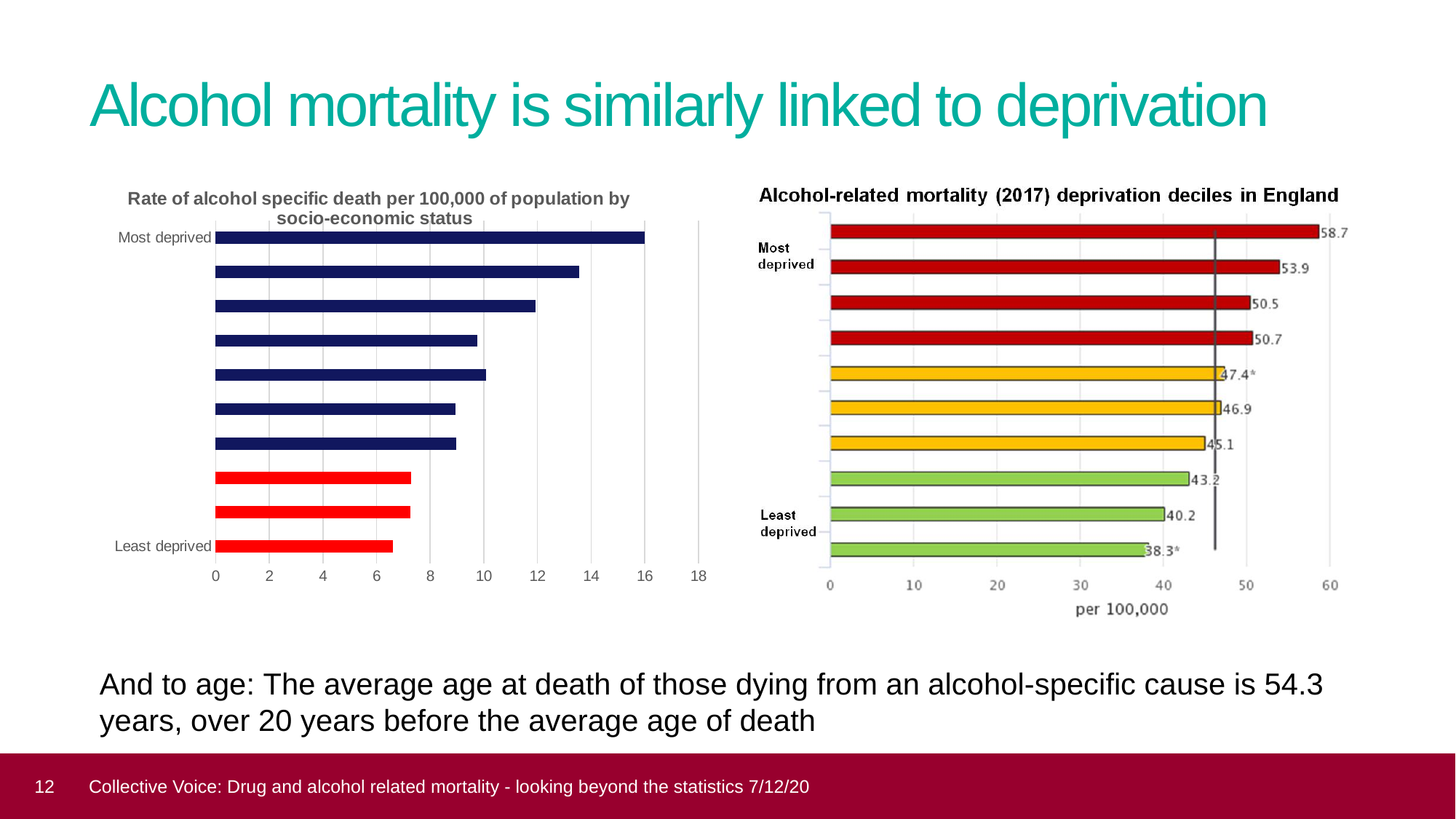
On the left chart (Rate of alcohol specific death per 100,000 of population by socio-economic status), is the value for Least deprived greater or less than 8? less On the left chart (Rate of alcohol specific death per 100,000 of population by socio-economic status), how many bars are plotted? 10 What kind of chart is the left chart (Rate of alcohol specific death per 100,000 of population by socio-economic status)? bar chart On the right chart (Alcohol-related mortality (2017) deprivation deciles in England), what is the lowest value shown? 38.3* On the left chart (Rate of alcohol specific death per 100,000 of population by socio-economic status), which category has the highest value? Most deprived On the right chart (Alcohol-related mortality (2017) deprivation deciles in England), what is the value of the top bar, for the most deprived decile? 58.7 On the right chart (Alcohol-related mortality (2017) deprivation deciles in England), what is the difference between the highest value (58.7) and the lowest value (38.3)? 20.4 On the right chart (Alcohol-related mortality (2017) deprivation deciles in England), which is larger: the second bar from the top (53.9) or the third bar from the top (50.5)? the second bar (53.9) On the right chart (Alcohol-related mortality (2017) deprivation deciles in England), what is the highest value shown? 58.7 On the right chart (Alcohol-related mortality (2017) deprivation deciles in England), do the values generally rise or fall going from the most deprived decile to the least deprived decile? fall On the left chart (Rate of alcohol specific death per 100,000 of population by socio-economic status), is the value for Most deprived greater or less than 14? greater On the right chart (Alcohol-related mortality (2017) deprivation deciles in England), how many bars are plotted? 10